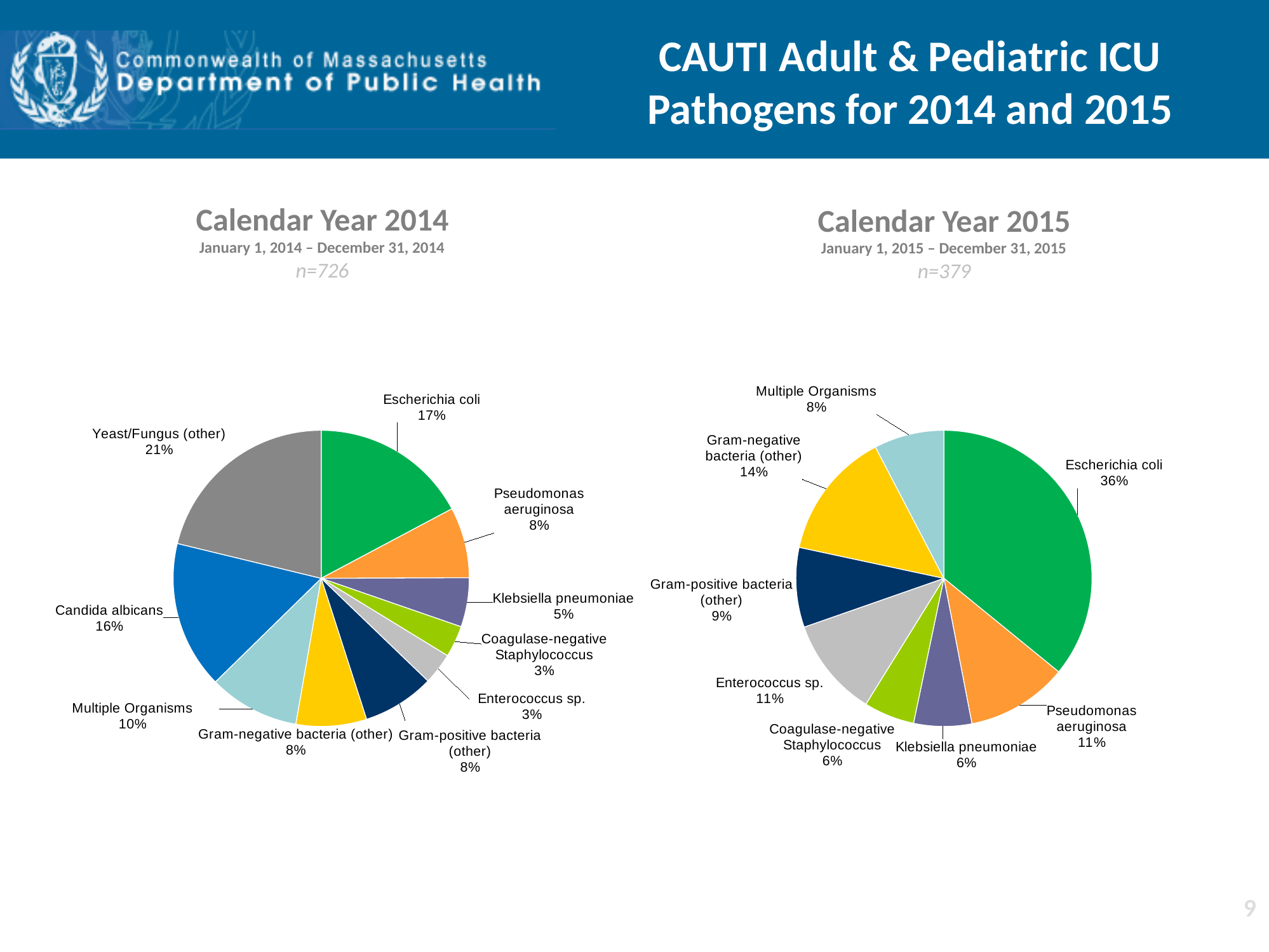
How many slices does the Calendar Year 2015 pie chart have? 8 In the Calendar Year 2014 chart, what is the difference between the Escherichia coli share and the Candida albicans share? 1% How many slices does the Calendar Year 2014 pie chart have? 10 In the Calendar Year 2014 chart, which pathogen has the largest slice? Yeast/Fungus (other) What is the n value shown for the Calendar Year 2015 chart? n=379 What type of chart is used for Calendar Year 2015? Pie chart In the Calendar Year 2014 chart, what share is Yeast/Fungus (other)? 21% In the Calendar Year 2015 chart, which is larger: Enterococcus sp. or Klebsiella pneumoniae? Enterococcus sp. In the Calendar Year 2015 chart, what share is Gram-negative bacteria (other)? 14% In the Calendar Year 2015 chart, which pathogen has the largest slice? Escherichia coli In the Calendar Year 2014 chart, what share is Multiple Organisms? 10% In the Calendar Year 2015 chart, what share is Escherichia coli? 36%